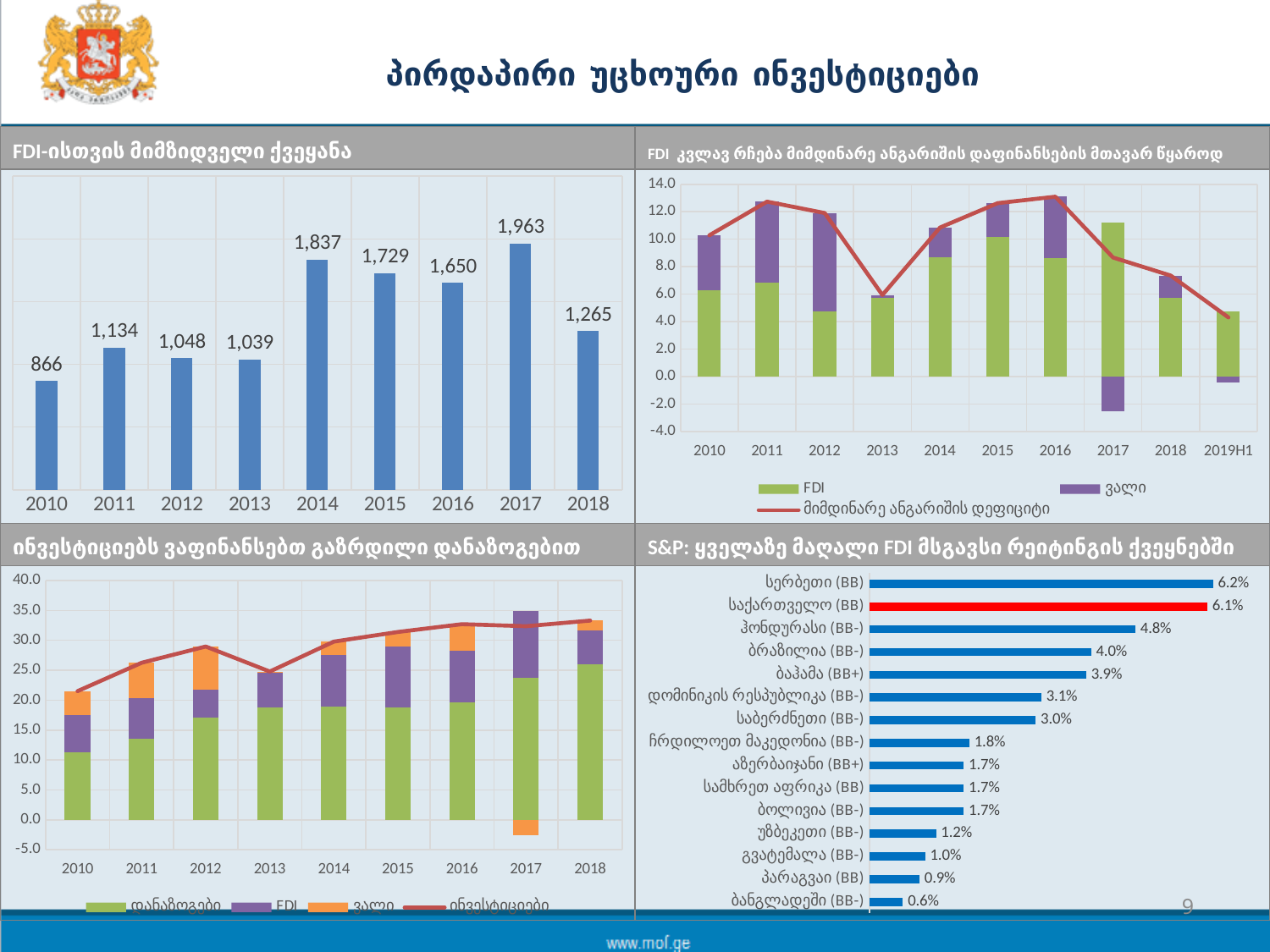
In the top-left chart (FDI-ისთვის მიმზიდველი ქვეყანა), what is the value for 2017? 1,963 In the bottom-right chart (S&P: ყველაზე მაღალი FDI მსგავსი რეიტინგის ქვეყნებში), what is the value for საქართველო (BB)? 6.1% In the top-left chart (FDI-ისთვის მიმზიდველი ქვეყანა), what is the value for 2010? 866 In the bottom-left chart (ინვესტიციებს ვაფინანსებთ გაზრდილი დანაზოგებით), how many series does the legend list? 4 In the bottom-right chart (S&P: ყველაზე მაღალი FDI მსგავსი რეიტინგის ქვეყნებში), which country has the lowest value? ბანგლადეში (BB-) In the top-left chart (FDI-ისთვის მიმზიდველი ქვეყანა), which year has the highest value? 2017 In the top-left chart (FDI-ისთვის მიმზიდველი ქვეყანა), how many years are shown? 9 What kind of chart is the bottom-right chart (S&P: ყველაზე მაღალი FDI მსგავსი რეიტინგის ქვეყნებში)? bar chart In the top-left chart (FDI-ისთვის მიმზიდველი ქვეყანა), which year has the lowest value? 2010 In the top-left chart (FDI-ისთვის მიმზიდველი ქვეყანა), what is the difference between the values for 2017 and 2018? 698 In the top-right chart (FDI კვლავ რჩება მიმდინარე ანგარიშის დაფინანსების მთავარ წყაროდ), is the FDI value for 2017 greater or less than 10.0? greater In the top-right chart (FDI კვლავ რჩება მიმდინარე ანგარიშის დაფინანსების მთავარ წყაროდ), how many series does the legend list? 3